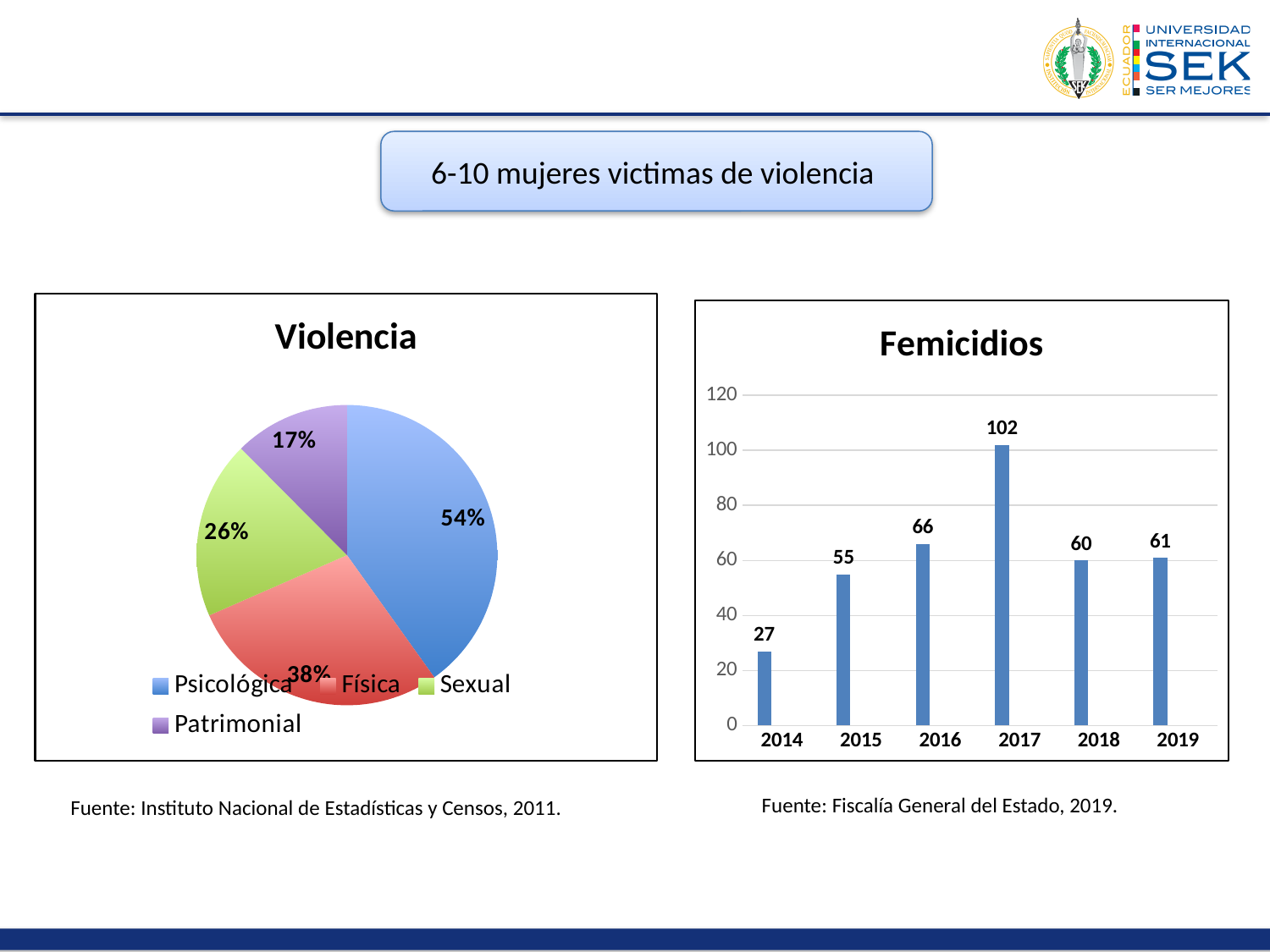
In the Femicidios chart, what is the value for 2014? 27 In the Violencia pie chart, which category has the largest slice? Psicológica In the Violencia pie chart, what share is labelled for Patrimonial? 17% In the Femicidios chart, what is the value for 2017? 102 In the Femicidios chart, how many years are shown on the x axis? 6 What kind of chart is the Femicidios chart? bar chart In the Femicidios chart, what is the difference between the values for 2017 and 2016? 36 In the Femicidios chart, which is larger, the value for 2015 or the value for 2016? 2016 In the Violencia pie chart, what share is labelled for Psicológica? 54% In the Femicidios chart, which year has the lowest value? 2014 In the Femicidios chart, which year has the highest value? 2017 How many entries does the legend of the Violencia pie chart list? 4